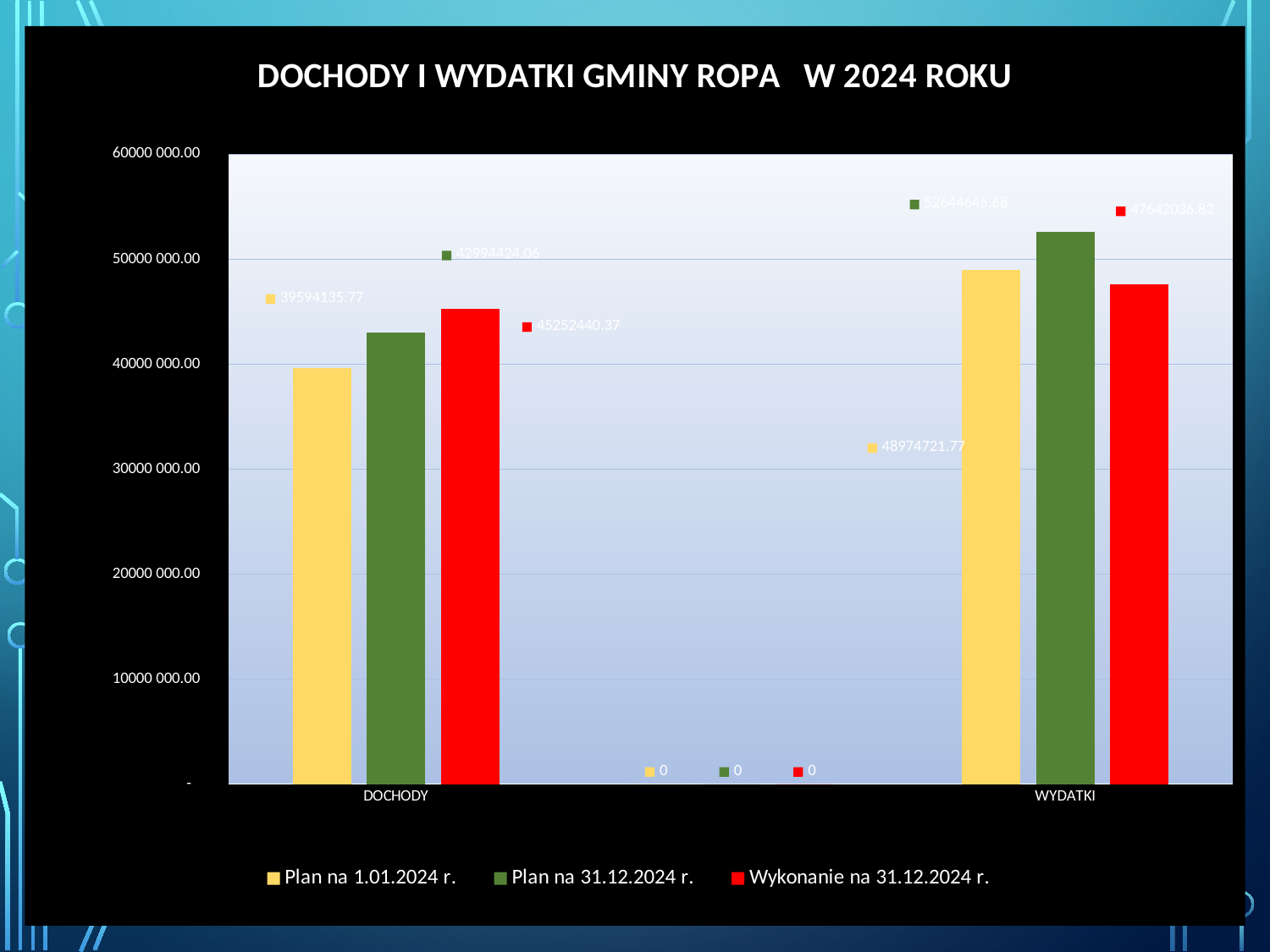
What is the value of Plan na 31.12.2024 r. for WYDATKI? 52644645.68 Which series has the lowest value for DOCHODY? Plan na 1.01.2024 r. What is the value of Wykonanie na 31.12.2024 r. for DOCHODY? 45252440.37 What type of chart is shown on the slide? Bar chart Is the value of Plan na 31.12.2024 r. for DOCHODY greater or less than 40000 000.00? greater What is the value of Plan na 1.01.2024 r. for DOCHODY? 39594135.77 What is the value of Wykonanie na 31.12.2024 r. for WYDATKI? 47642036.82 How many series does the legend list? 3 What is the difference between Wykonanie na 31.12.2024 r. and Plan na 1.01.2024 r. for DOCHODY? 5658304.60 What is the difference between Plan na 31.12.2024 r. and Plan na 1.01.2024 r. for WYDATKI? 3669923.91 Which is larger for WYDATKI: Plan na 1.01.2024 r. or Wykonanie na 31.12.2024 r.? Plan na 1.01.2024 r. Which series has the highest value for WYDATKI? Plan na 31.12.2024 r.